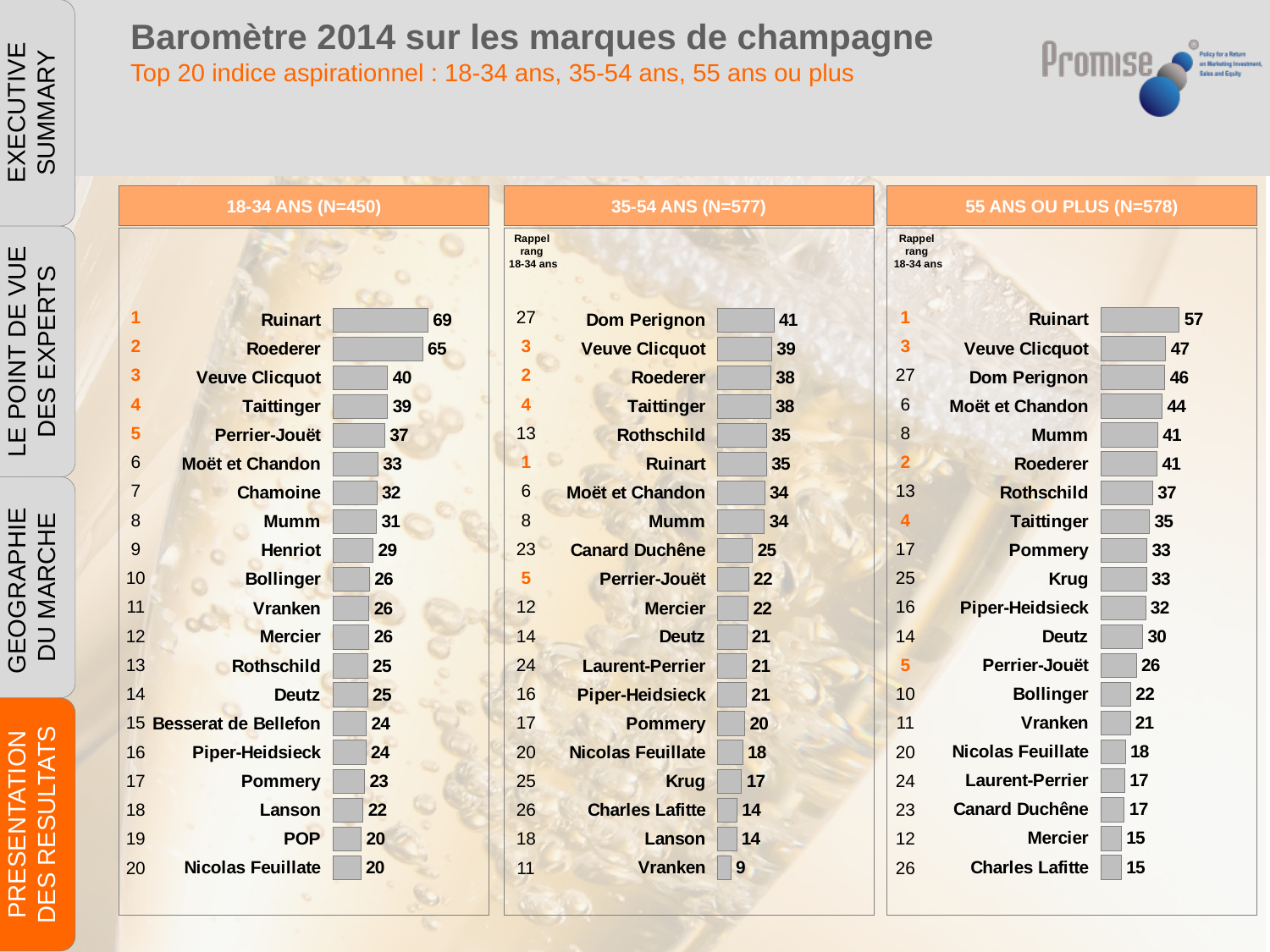
How many brands are shown in the 18-34 ANS (N=450) chart? 20 In the 55 ANS OU PLUS (N=578) chart, which brand has the highest value? Ruinart In the 18-34 ANS (N=450) chart, which brand has the highest value? Ruinart In the 35-54 ANS (N=577) chart, what is the value for Dom Perignon? 41 In the 35-54 ANS (N=577) chart, which is larger, the value for Rothschild or the value for Canard Duchêne? Rothschild How many charts are shown on the slide? 3 In the 18-34 ANS (N=450) chart, what is the value for Ruinart? 69 What kind of chart is the 35-54 ANS (N=577) chart? Bar chart In the 55 ANS OU PLUS (N=578) chart, what is the difference between the values for Ruinart and Veuve Clicquot? 10 In the 55 ANS OU PLUS (N=578) chart, what is the value for Moët et Chandon? 44 In the 35-54 ANS (N=577) chart, which brand has the lowest value? Vranken In the 18-34 ANS (N=450) chart, what is the difference between the values for Ruinart and Roederer? 4